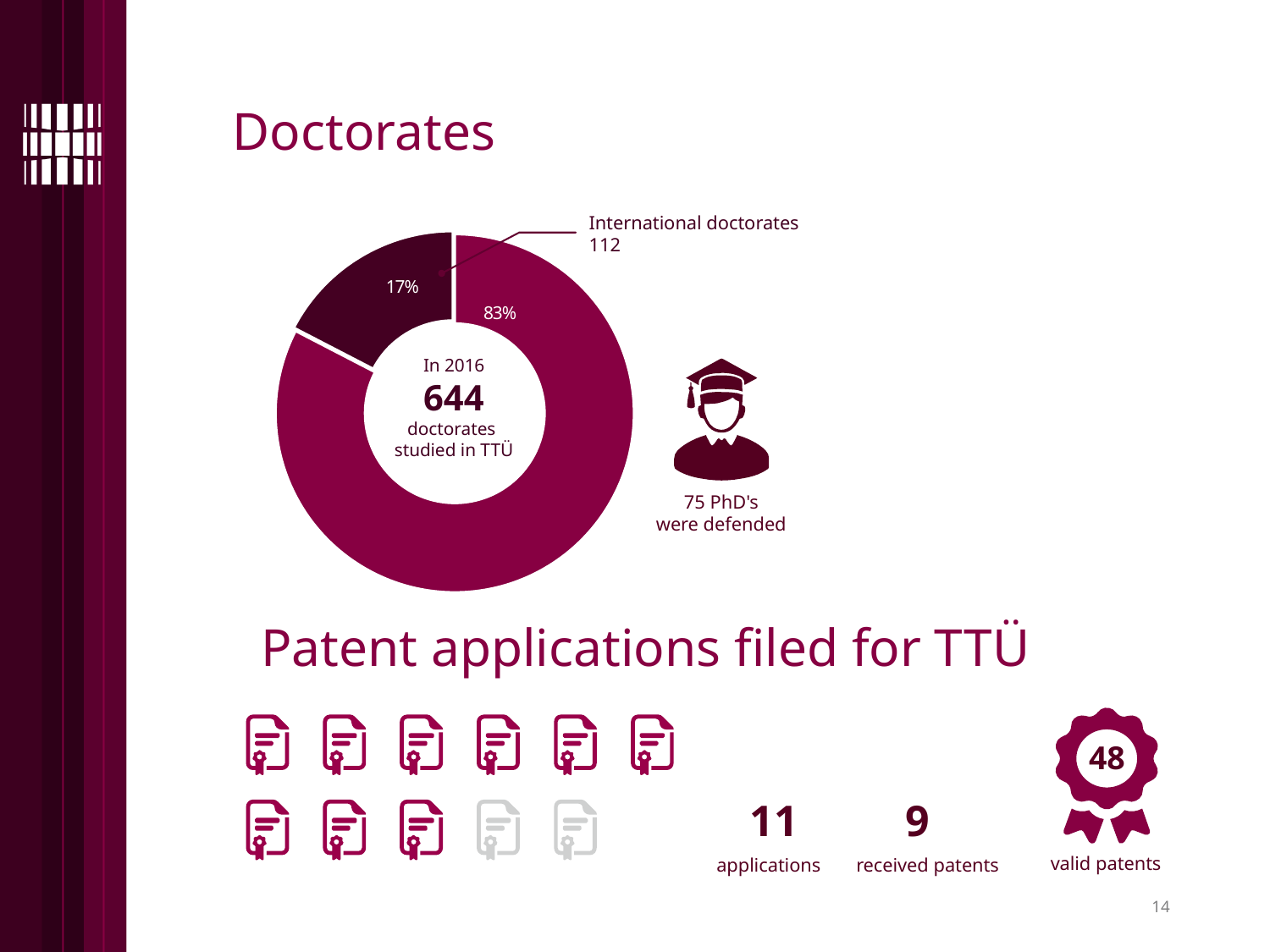
What percentage is shown on the larger slice of the donut chart? 83% Which year is referenced in the centre of the donut chart? 2016 What kind of chart is shown on the Doctorates slide? donut chart What total number of doctorates is shown in the centre of the donut chart? 644 How many international doctorates are shown in the chart's callout label? 112 Which slice of the donut chart is the smallest? International doctorates (17%) Which slice of the donut chart is larger, the 17% slice or the 83% slice? the 83% slice What share of the donut chart is labelled International doctorates? 17% How many slices does the donut chart have? 2 What is the difference in percentage points between the two slices of the donut chart? 66 percentage points What is the title of the slide containing the donut chart? Doctorates